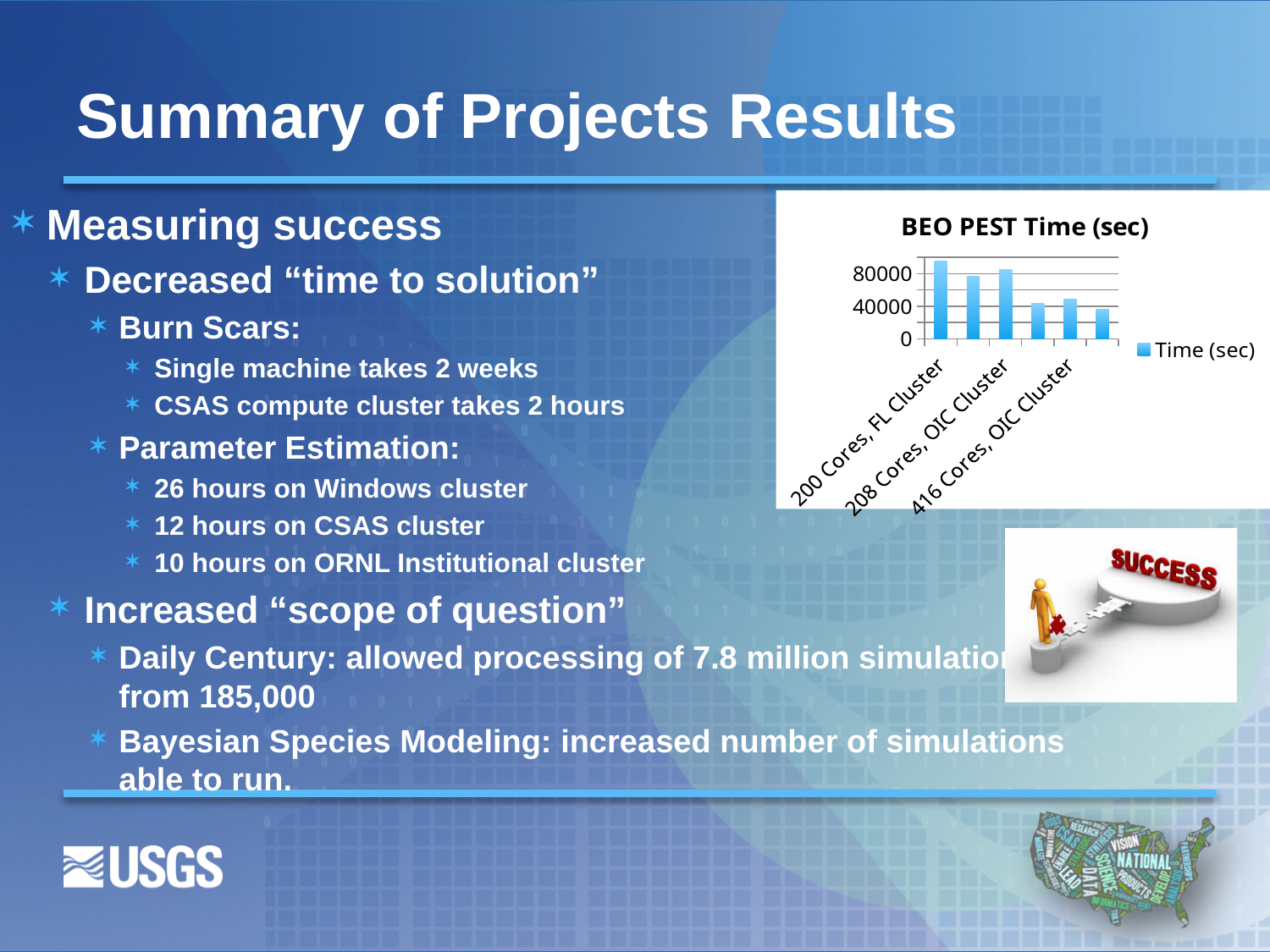
Is the value for 416 Cores, OIC Cluster greater or less than 40000? greater Is the rightmost bar in the chart greater or less than 40000? less Is the value for 200 Cores, FL Cluster greater or less than 80000? greater How many bars are plotted in the BEO PEST Time (sec) chart? 6 Do the bar values generally rise or fall from left to right across the chart? fall How many series does the chart's legend list? 1 Which labelled category has the highest BEO PEST time? 200 Cores, FL Cluster What is the name of the series shown in the chart's legend? Time (sec) What kind of chart is shown on the slide? bar chart Which is larger, the value for 200 Cores, FL Cluster or the value for 416 Cores, OIC Cluster? 200 Cores, FL Cluster What is the title of the chart on the slide? BEO PEST Time (sec)